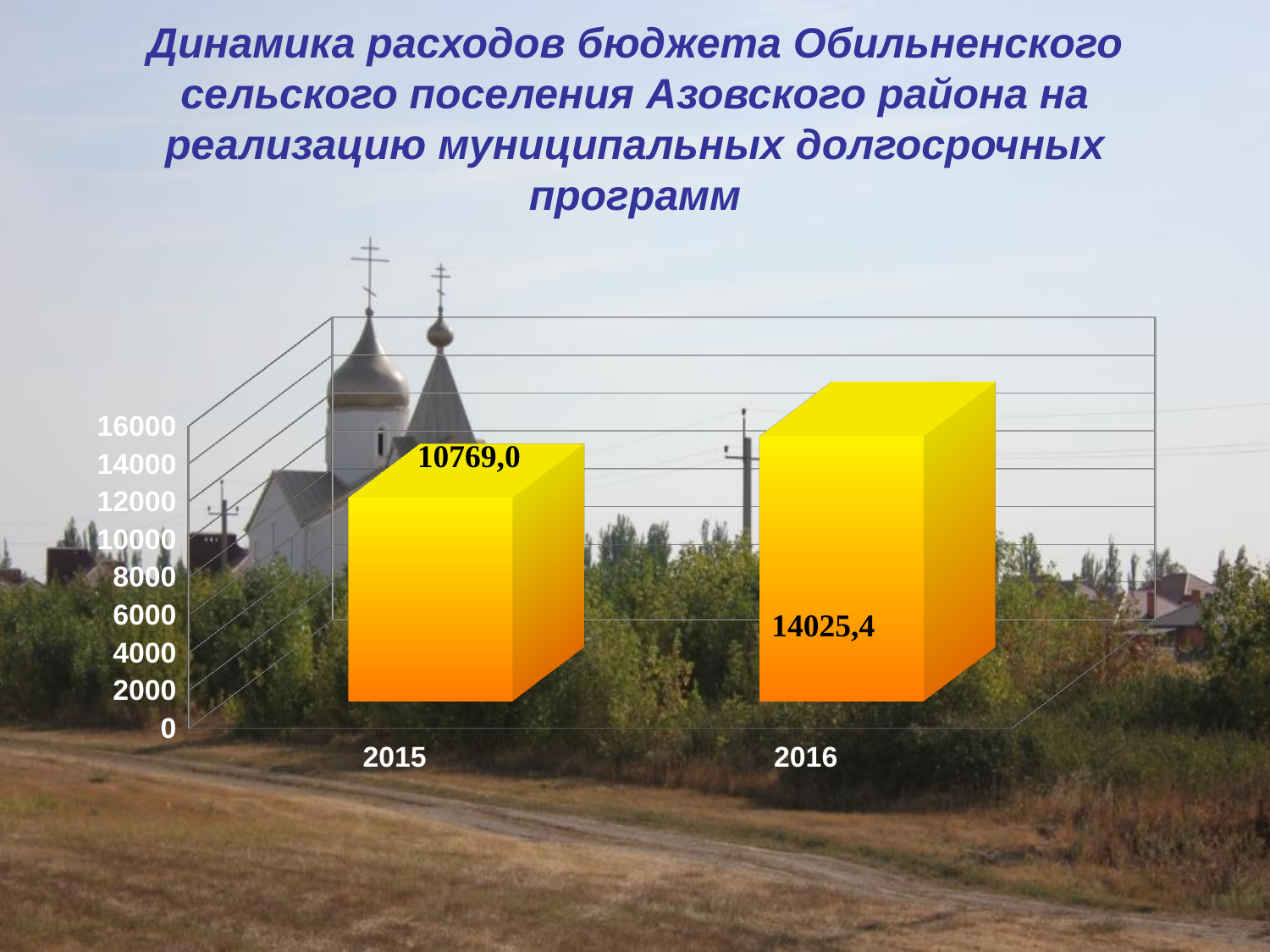
Is the value for 2015 greater or less than 12000? less Which year has the lowest value? 2015 What is the difference between the values for 2016 and 2015? 3256,4 Which is larger, the value for 2015 or the value for 2016? 2016 What is the value for 2016? 14025,4 Which year has the highest value? 2016 How many years are shown on the chart? 2 What is the value for 2015? 10769,0 Is the value for 2016 greater or less than 12000? greater Do the values rise or fall from 2015 to 2016? rise What is the highest value shown on the vertical axis? 16000 What kind of chart is shown on the slide? bar chart